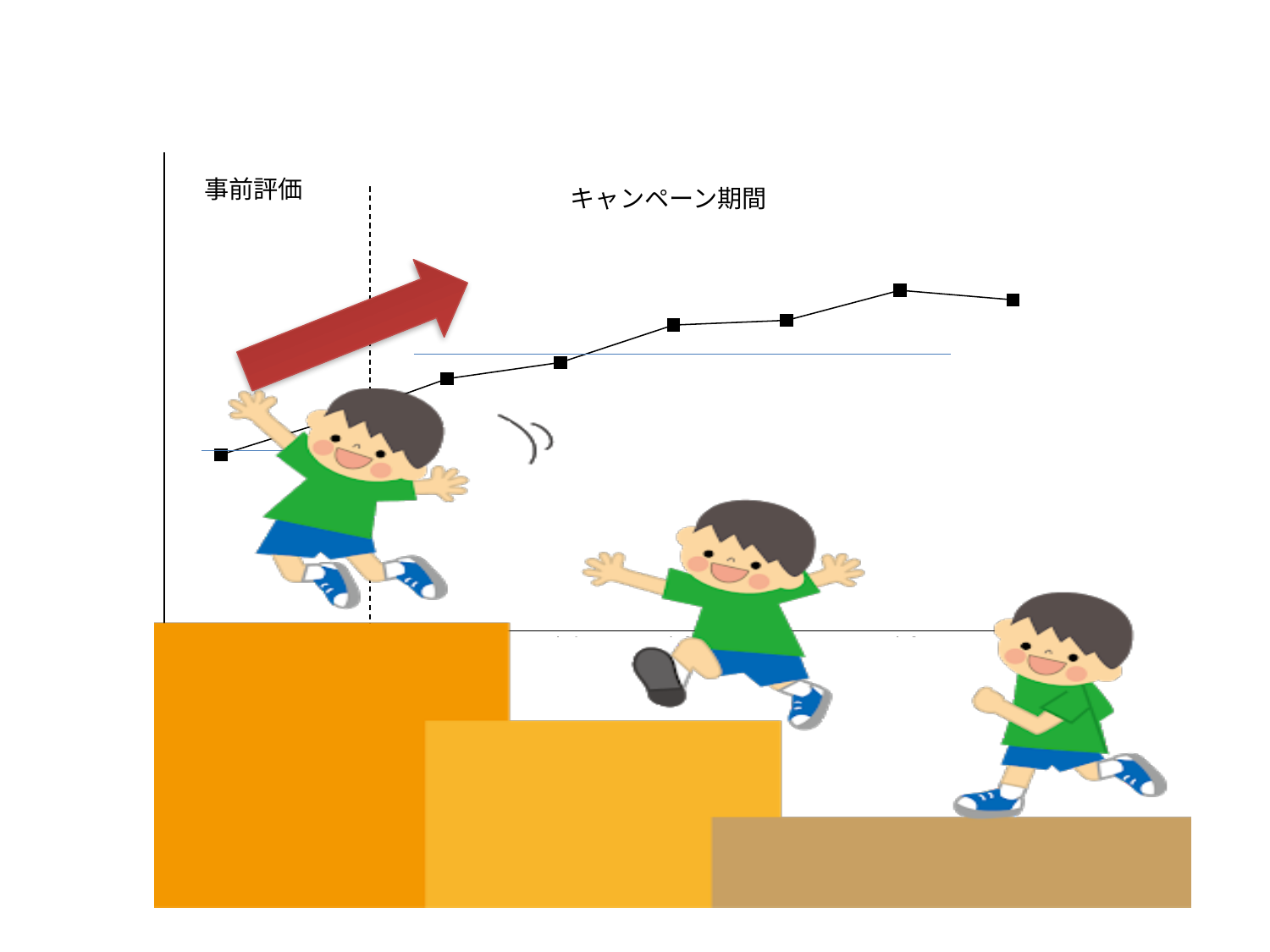
Is the plotted point in the 事前評価 section higher or lower than the points in the キャンペーン期間 section? lower What kind of chart is shown on the slide? line chart What label is written above the left section of the chart, before the dashed vertical line? 事前評価 What label is written above the right section of the chart, after the dashed vertical line? キャンペーン期間 Do the plotted values generally rise or fall from left to right along the x axis? rise Which is higher on the chart, the first plotted point on the left or the last plotted point on the right? the last point on the right